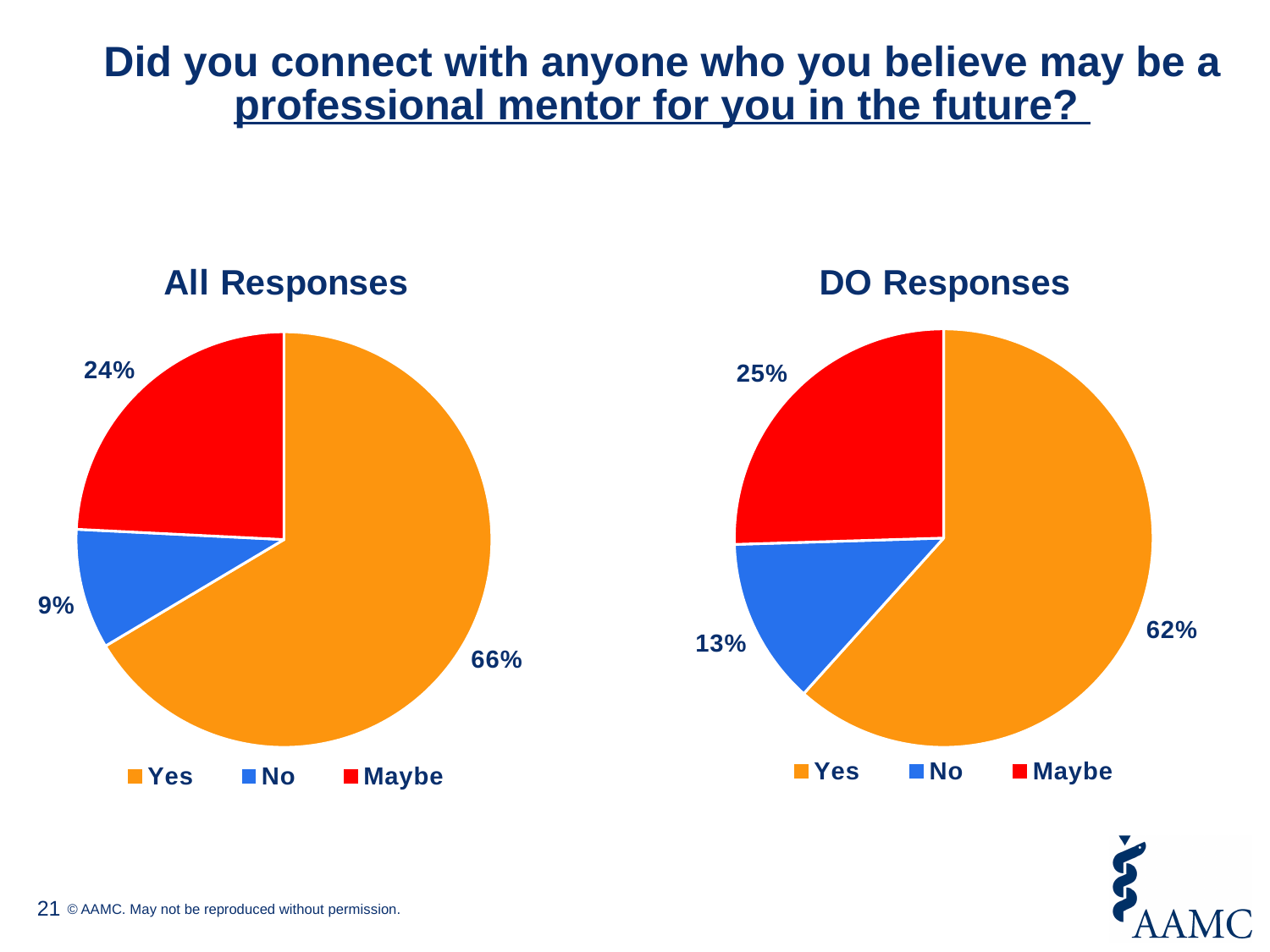
Is the No share larger in the All Responses chart or the DO Responses chart? DO Responses What is the difference between the Yes share in the All Responses chart and the Yes share in the DO Responses chart? 4% In the DO Responses chart, what percentage of respondents answered Maybe? 25% In the DO Responses chart, what percentage of respondents answered No? 13% How many entries does the legend of the DO Responses chart list? 3 What type of chart is the DO Responses chart? Pie chart In the All Responses chart, what is the difference between the Maybe share and the No share? 15% In the DO Responses chart, which response has the smallest share? No In the All Responses chart, which response has the largest share? Yes In the All Responses chart, what percentage of respondents answered Yes? 66% How many slices does the All Responses chart have? 3 In the All Responses chart, what colour represents the Maybe response? Red